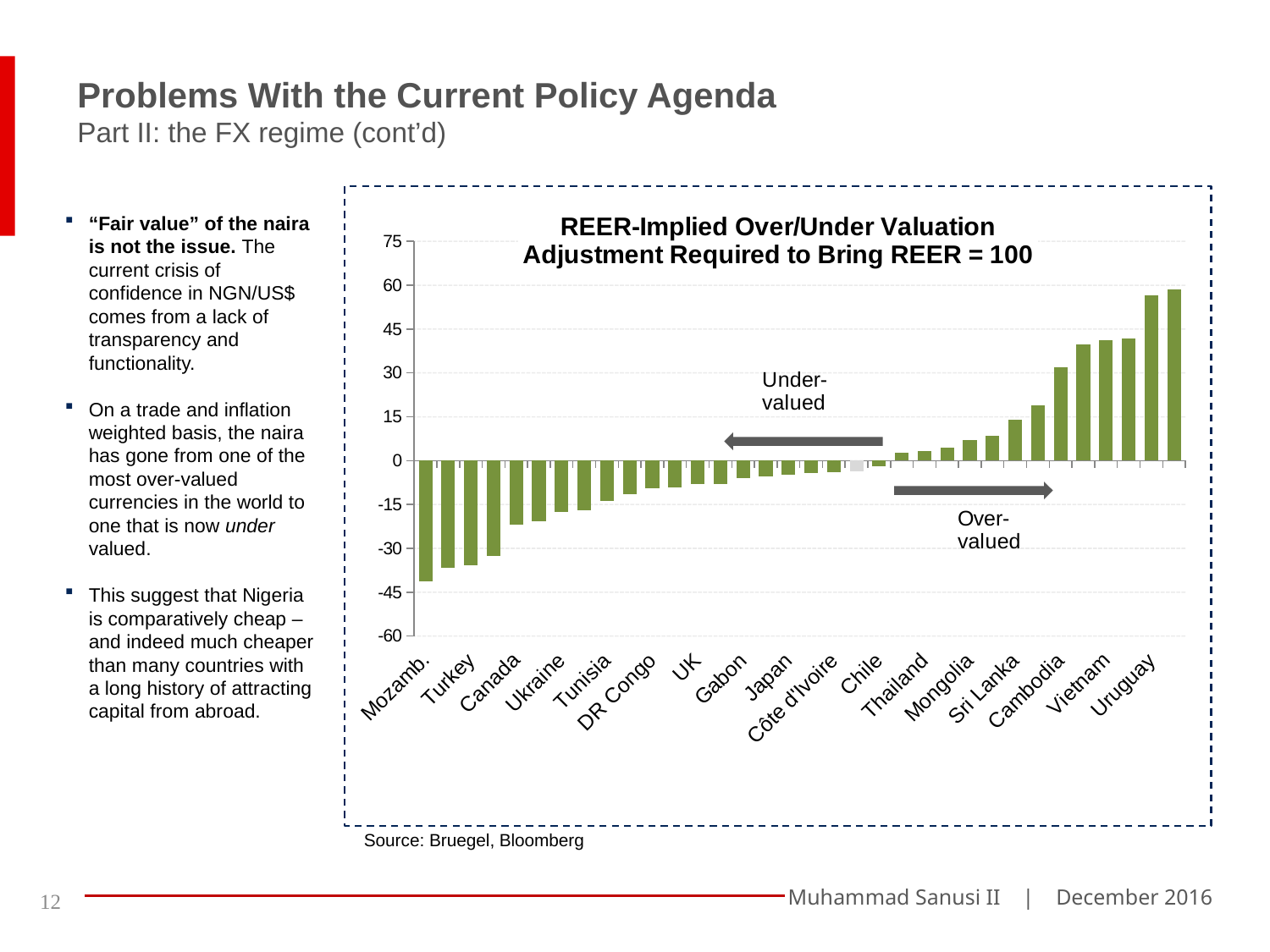
Which country has the lowest REER-implied valuation adjustment in the chart? Mozamb. Which has the larger value, Uruguay or Mozamb.? Uruguay What kind of chart is shown on the slide? bar chart Is the value for Mozamb. greater or less than -30? less Is the value for Uruguay greater or less than 45? greater What source is cited below the chart? Bruegel, Bloomberg Is the value for Sri Lanka greater or less than 30? less What is the title of the chart? REER-Implied Over/Under Valuation Adjustment Required to Bring REER = 100 Do the bar values rise or fall moving from left to right along the x axis? rise